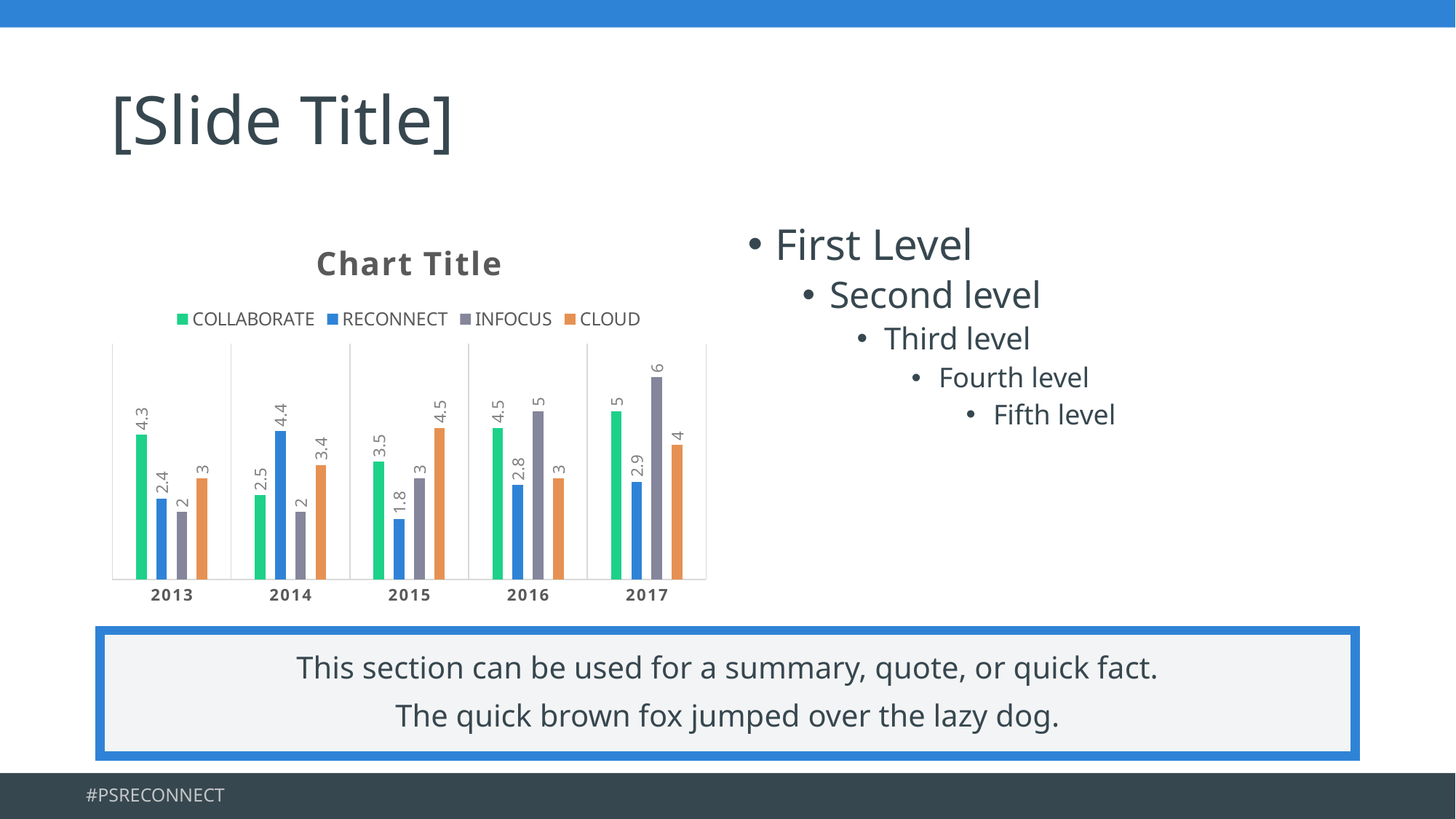
What is the value for COLLABORATE in 2013? 4.3 Which is larger in 2016, the COLLABORATE value or the INFOCUS value? INFOCUS What is the value for RECONNECT in 2016? 2.8 In which year is the RECONNECT value highest? 2014 In which year is the RECONNECT value lowest? 2015 What is the difference between the INFOCUS value in 2017 and the INFOCUS value in 2013? 4 How many series does the legend list? 4 What is the value for CLOUD in 2015? 4.5 How many years are shown on the x axis? 5 What is the value for INFOCUS in 2017? 6 What kind of chart is shown on the slide? Bar chart Does the COLLABORATE value rise or fall from 2015 to 2017? Rise